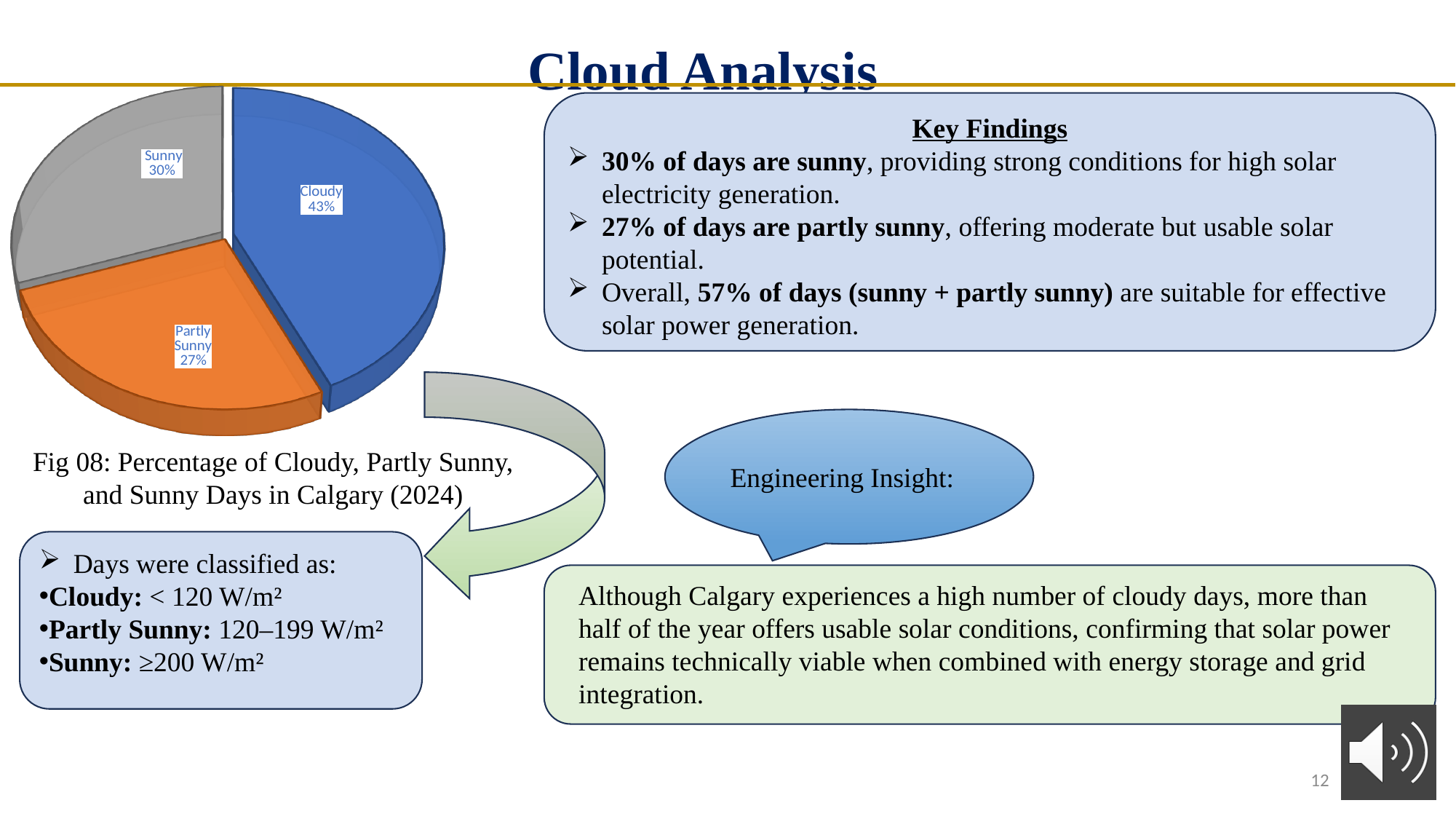
What percentage of days are Partly Sunny in the pie chart? 27% What percentage of days are Sunny in the pie chart? 30% Which category has the smallest share of the pie chart? Partly Sunny What percentage of days are Cloudy in the pie chart? 43% What is the figure caption of the pie chart? Fig 08: Percentage of Cloudy, Partly Sunny, and Sunny Days in Calgary (2024) What type of chart is shown on the slide? Pie chart What is the combined share of the Sunny and Partly Sunny slices? 57% How many categories are shown in the pie chart? 3 Which slice is larger, Sunny or Partly Sunny? Sunny What colour is the Cloudy slice of the pie chart? Blue What is the difference in percentage points between the Cloudy and Sunny slices? 13 Which category has the largest share of the pie chart? Cloudy